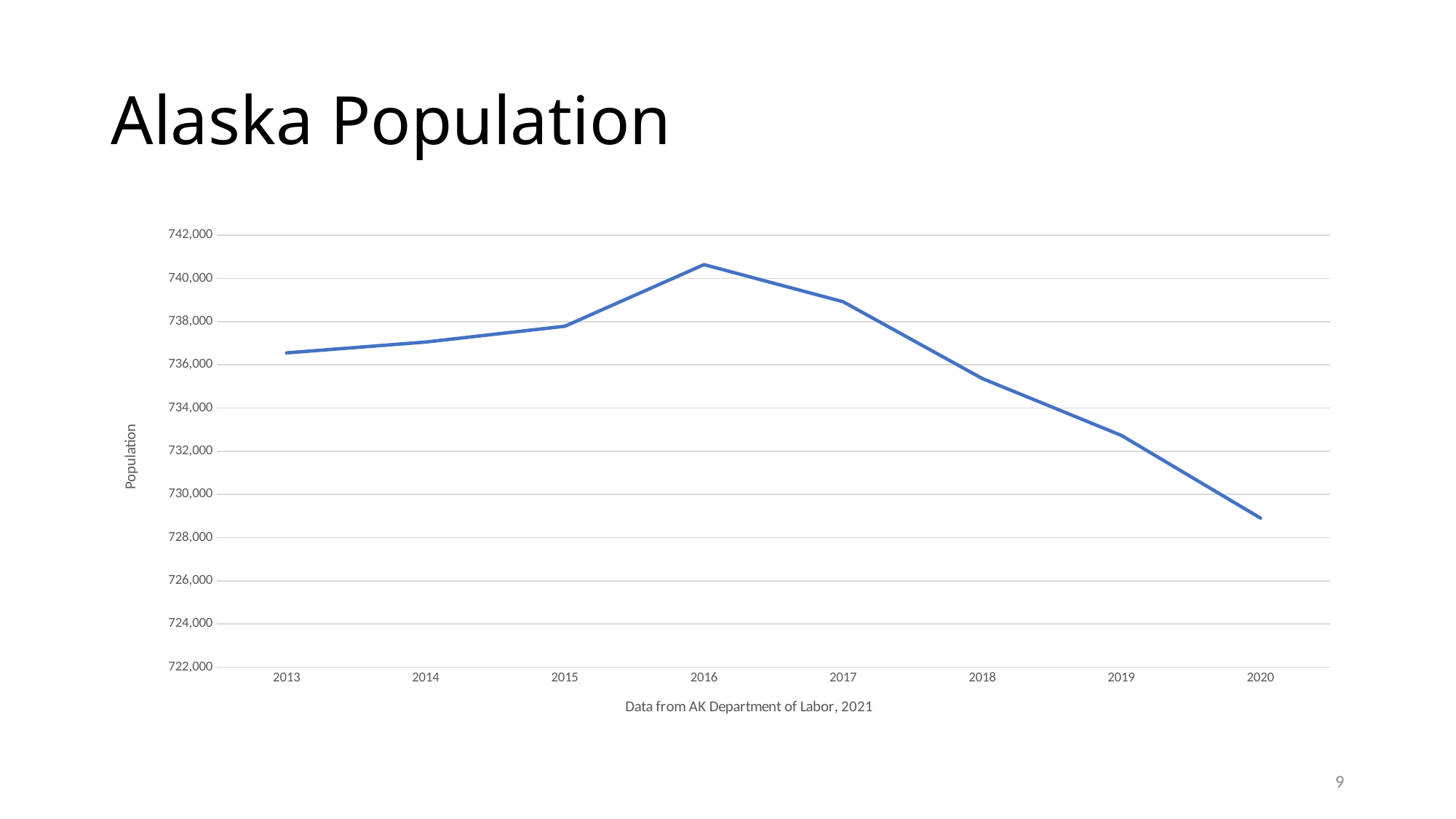
What source is cited below the x axis of the chart? Data from AK Department of Labor, 2021 Is the population value for 2013 greater or less than 736,000? greater Does the population rise or fall between 2016 and 2020? fall Which year has the larger population value, 2015 or 2019? 2015 What kind of chart is shown on the slide? line chart Is the population value for 2018 greater or less than 736,000? less In which year does the plotted population reach its highest point? 2016 In which year is the plotted population lowest? 2020 What is the label on the vertical axis of the chart? Population Is the population value for 2016 greater or less than 740,000? greater How many years are plotted on the x axis of the chart? 8